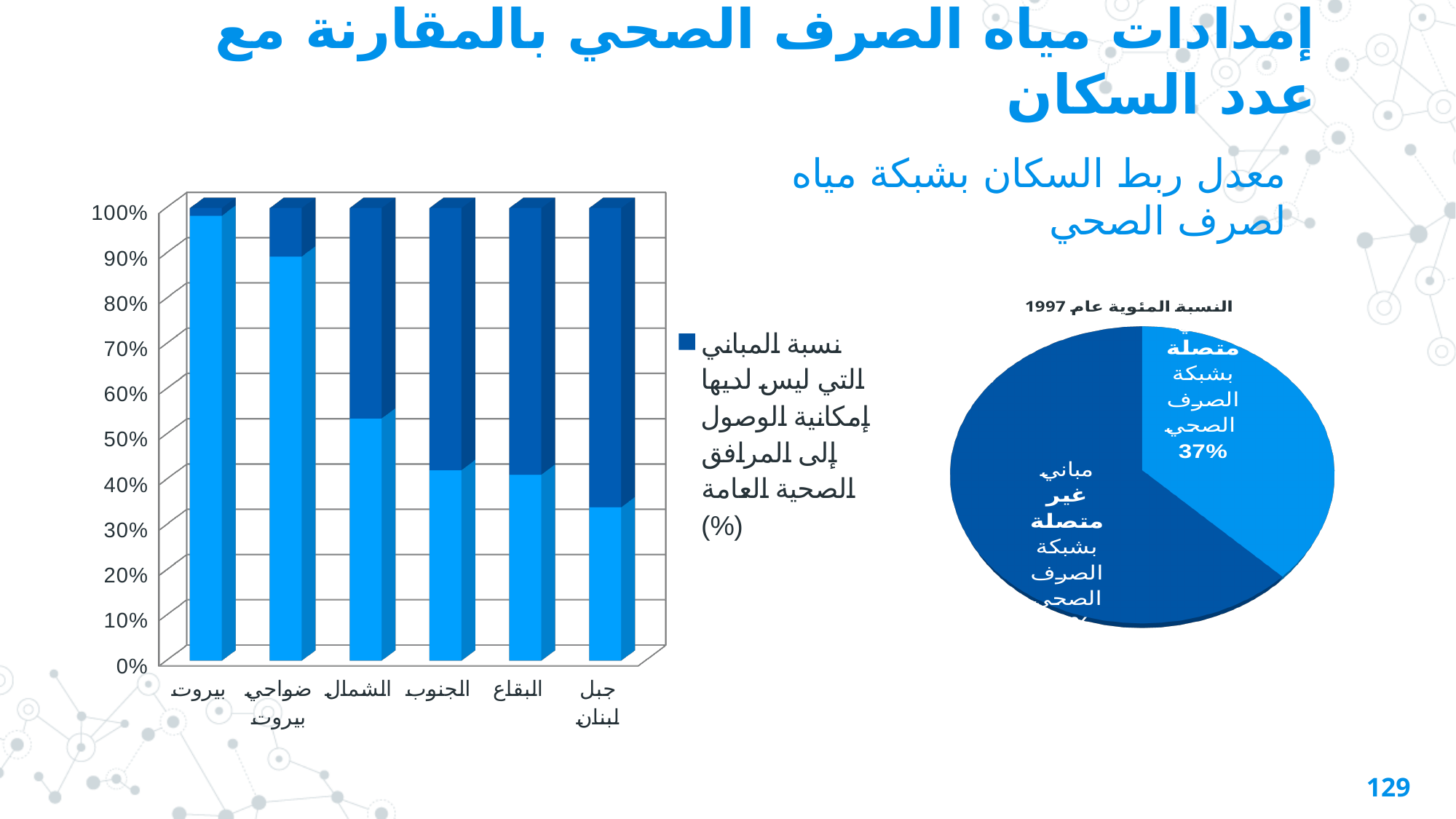
How many series does the legend of the bar chart on the left list? 1 In the pie chart titled النسبة المئوية عام 1997, what share is shown for مباني متصلة بشبكة الصرف الصحي? 37% What kind of chart is the chart on the left of the slide? bar chart In the bar chart on the left, which category has the highest value for نسبة المباني التي ليس لديها إمكانية الوصول إلى المرافق الصحية العامة? جبل لبنان In the bar chart on the left, which category has the lowest value for نسبة المباني التي ليس لديها إمكانية الوصول إلى المرافق الصحية العامة? بيروت How many categories are shown on the x axis of the bar chart on the left? 6